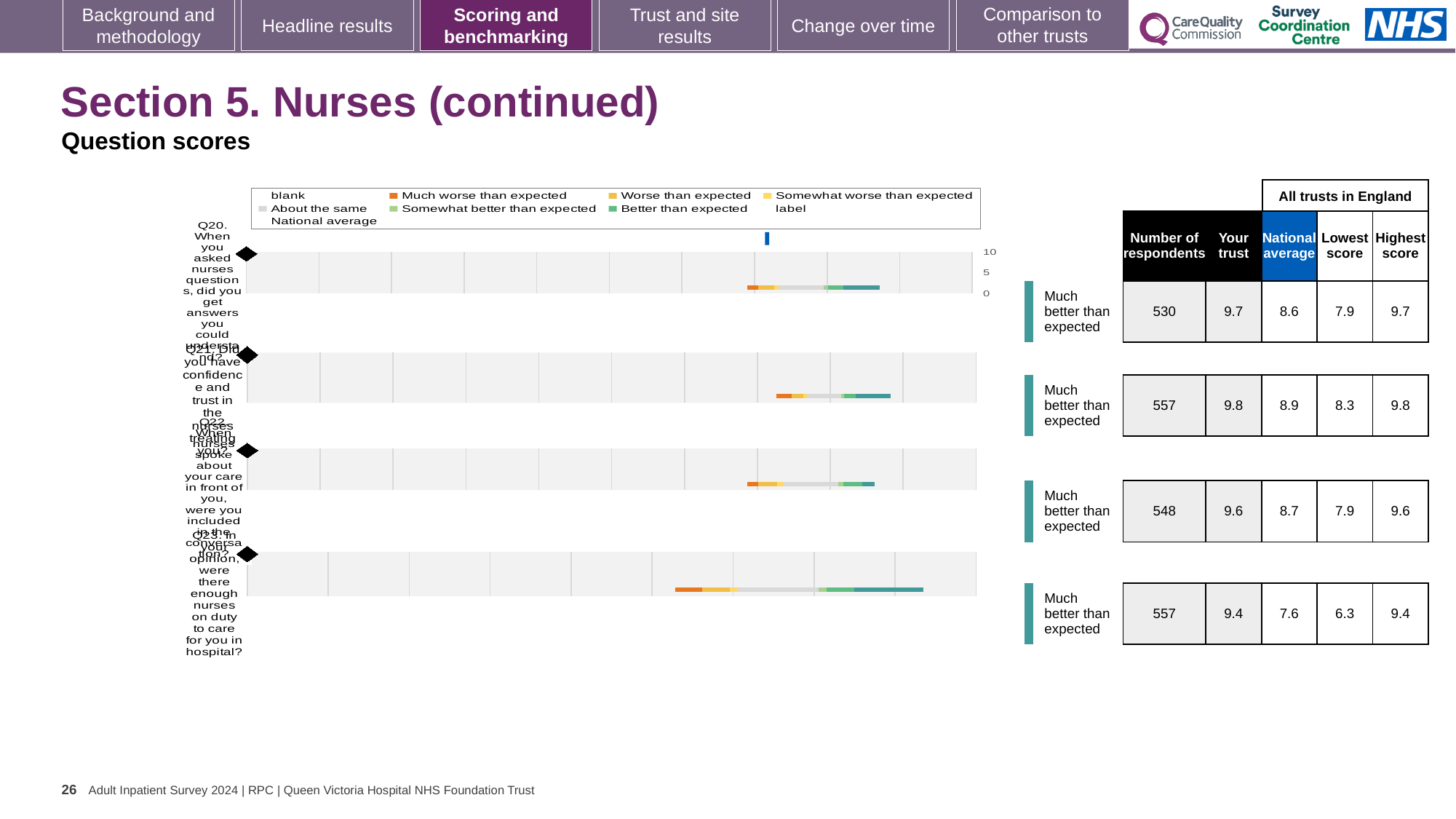
What benchmark category is shown next to each of the four question charts? Much better than expected In the table beside the charts, which question has the highest 'Your trust' score? Q21 In the table beside the charts, is the lowest score for Q21 larger or smaller than the lowest score for Q22? larger In the table beside the charts, what is the 'Your trust' score for Q20? 9.7 In the table beside the charts, which question has the lowest 'Your trust' score? Q23 In the table beside the charts, how many respondents answered Q22? 548 In the table beside the charts, what is the difference between the 'Your trust' score and the national average for Q23? 1.8 What is the highest value shown on the score axis of the Q20 chart? 10 In the chart legend, which colour represents 'Much worse than expected'? orange How many questions (Q20 to Q23) have a benchmark bar plotted on the slide? 4 What kind of chart is used to show the question scores for Q20 to Q23? bar chart In the table beside the charts, what is the national average for Q23? 7.6